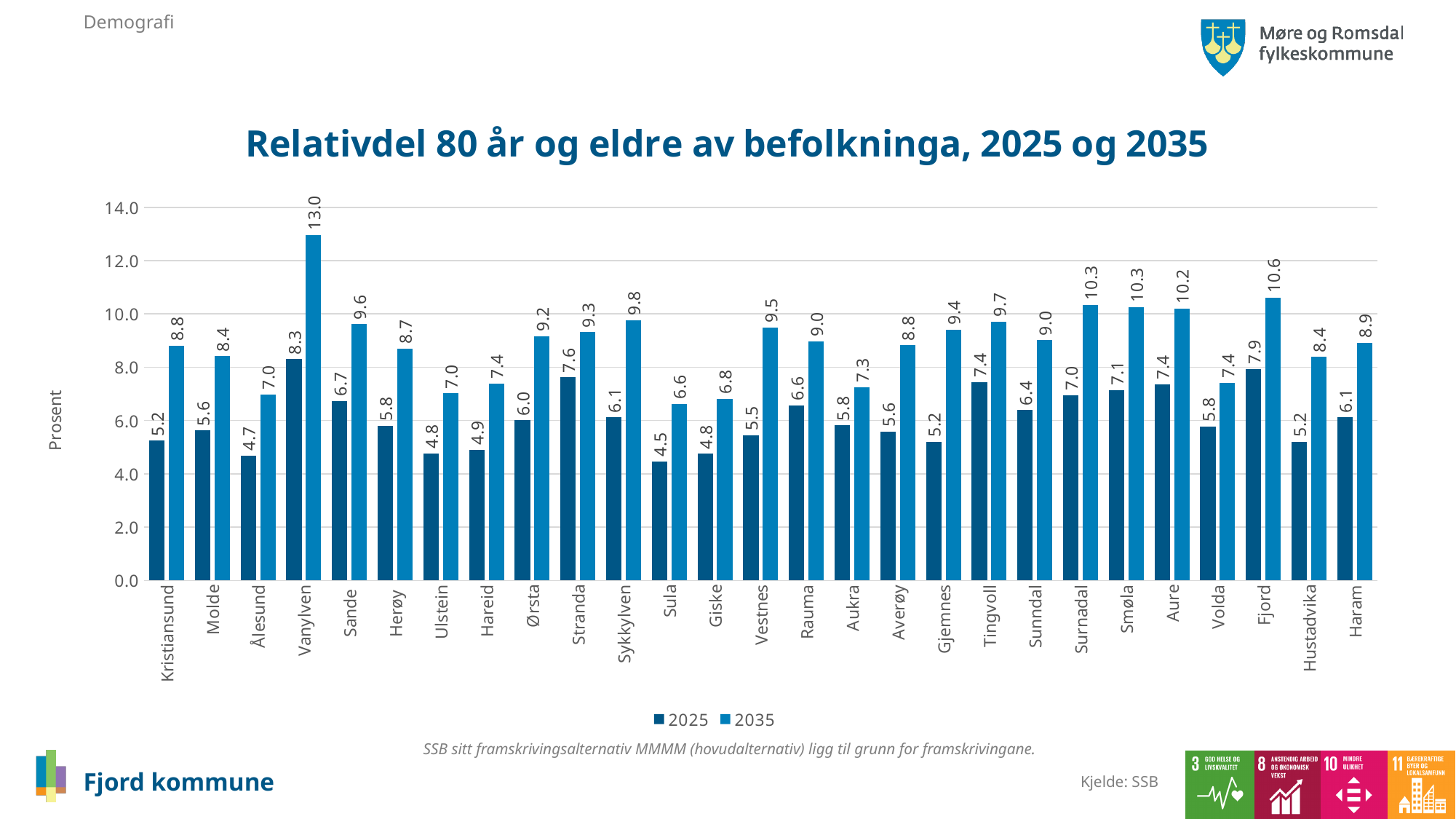
What is the 2025 value for Fjord? 7.9 How many series does the legend list? 2 What is the 2035 value for Vanylven? 13.0 What is the difference between the 2035 and 2025 values for Kristiansund? 3.6 What is the label on the y axis? Prosent Which municipality has the highest 2035 value? Vanylven How many municipalities are shown on the x axis? 27 Which municipality has the lowest 2025 value? Sula Is the 2035 value for Fjord greater or less than 10.0? greater What kind of chart is this? Bar chart What is the 2035 value for Surnadal? 10.3 Which is larger, the 2025 value for Stranda or the 2025 value for Molde? Stranda